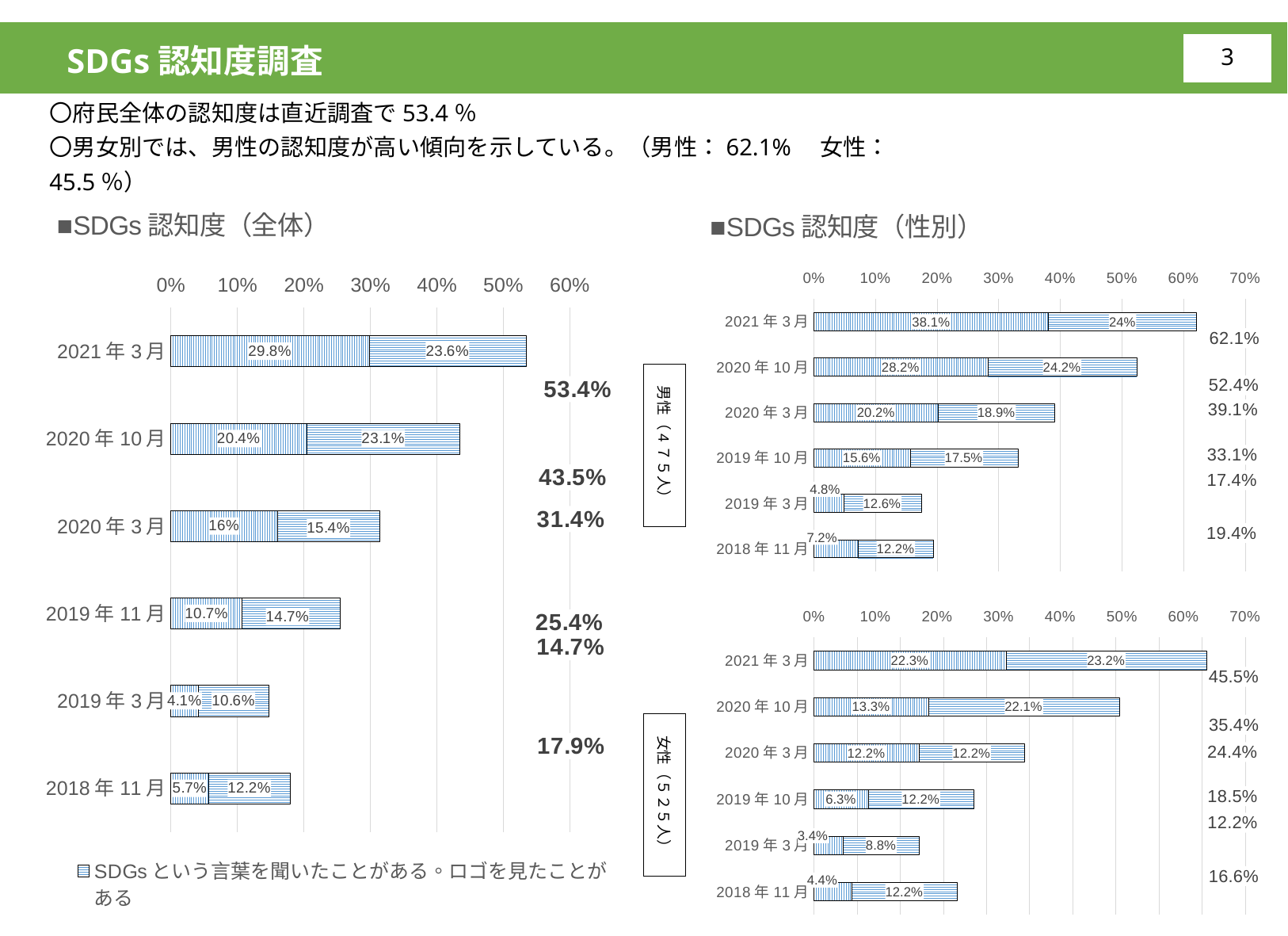
In the SDGs認知度（全体） chart, which is larger: the first segment for 2020年3月 or the first segment for 2019年11月? 2020年3月 In the SDGs認知度（全体） chart, what is the value of the first (left) segment for 2021年3月? 29.8% What type of chart is the SDGs認知度（全体） chart? Stacked horizontal bar chart In the 男性 chart of SDGs認知度（性別）, what is the value of the second (right) segment for 2021年3月? 24% In the 女性 chart of SDGs認知度（性別）, what is the value of the first (left) segment for 2020年10月? 13.3% In the 女性 chart of SDGs認知度（性別）, which survey period has the highest total awareness? 2021年3月 In the SDGs認知度（全体） chart, what is the total awareness shown for 2020年10月? 43.5% In the 男性 chart of SDGs認知度（性別）, is the total for 2021年3月 greater or less than 60%? greater In the SDGs認知度（全体） chart, which survey period has the lowest total awareness? 2019年3月 In the SDGs認知度（全体） chart, how many survey periods are shown? 6 What is the difference between the 2021年3月 total awareness in the 男性 chart and in the 女性 chart? 16.6% In the 男性 chart of SDGs認知度（性別）, what is the total awareness for 2020年3月? 39.1%